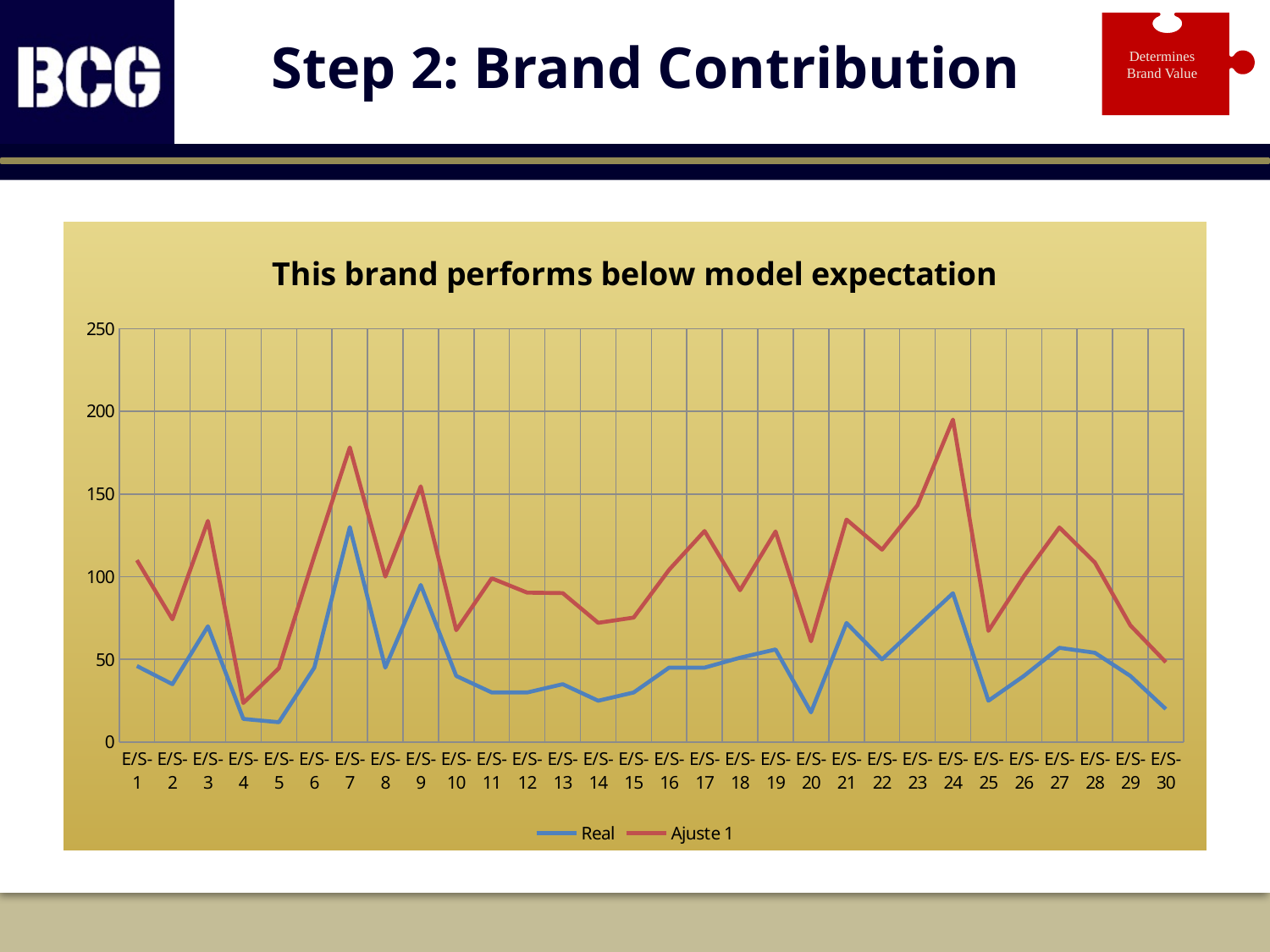
At which period does the Real series reach its highest value? E/S-7 Which series is drawn in red? Ajuste 1 What kind of chart is shown on the slide? Line chart At E/S-24, which series has the larger value, Real or Ajuste 1? Ajuste 1 How many series does the legend list? 2 At which period does the Ajuste 1 series reach its highest value? E/S-24 At which period does the Ajuste 1 series reach its lowest value? E/S-4 What is the title of the chart? This brand performs below model expectation Is the value of Real at E/S-4 greater or less than 50? less Does the Ajuste 1 series rise or fall from E/S-24 to E/S-25? Fall How many points (E/S periods) are plotted along the x axis? 30 Is the value of Ajuste 1 at E/S-7 greater or less than 150? greater